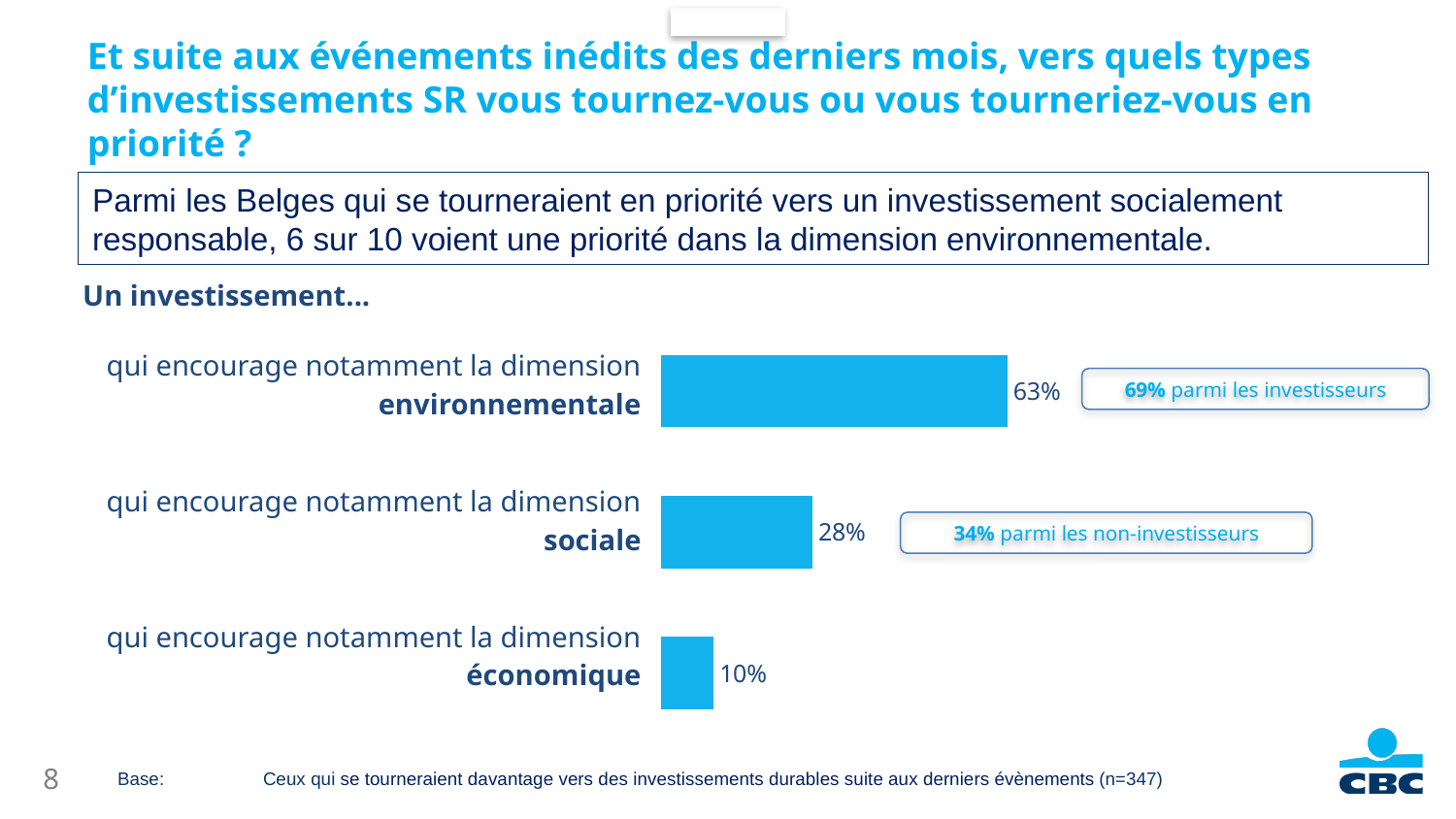
How many categories (bars) are shown in the chart? 3 What is the difference between the environmental and social dimension values? 35% What is the difference between the social and economic dimension values? 18% What is the value for the social dimension (sociale)? 28% Which dimension has the highest value? environnementale What is the value for the environmental dimension (environnementale)? 63% According to the callout, what is the share for the environmental dimension among investors (parmi les investisseurs)? 69% What kind of chart is shown on the slide? bar chart Which dimension has the lowest value? économique According to the callout, what is the share for the social dimension among non-investors (parmi les non-investisseurs)? 34% What is the value for the economic dimension (économique)? 10% Which is larger, the value for the social dimension or the economic dimension? sociale